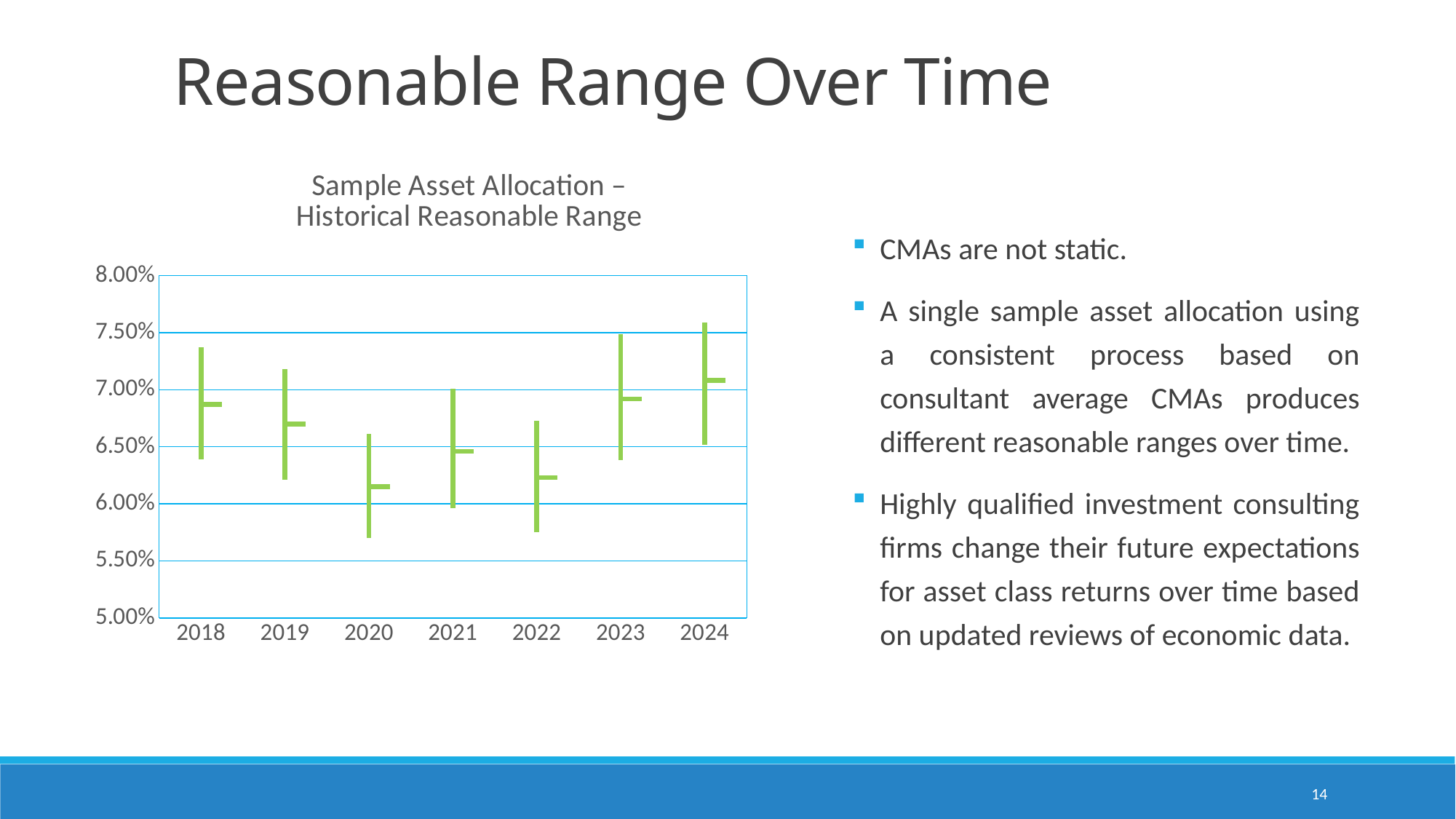
Which year has the highest midpoint marker? 2024 What kind of chart is shown on the slide? High-low range (stock) chart Is the bottom of the range for 2020 greater or less than 6.00%? less Which year has a higher top of range, 2018 or 2019? 2018 What is the title of the chart on the slide? Sample Asset Allocation – Historical Reasonable Range Do the midpoint markers rise or fall from 2020 to 2024? rise How many years are shown on the x axis of the chart? 7 Which year has the highest top of its reasonable range? 2024 Is the top of the range for 2024 greater or less than 7.50%? greater Is the top of the range for 2018 greater or less than 7.00%? greater Which year has a higher bottom of range, 2020 or 2024? 2024